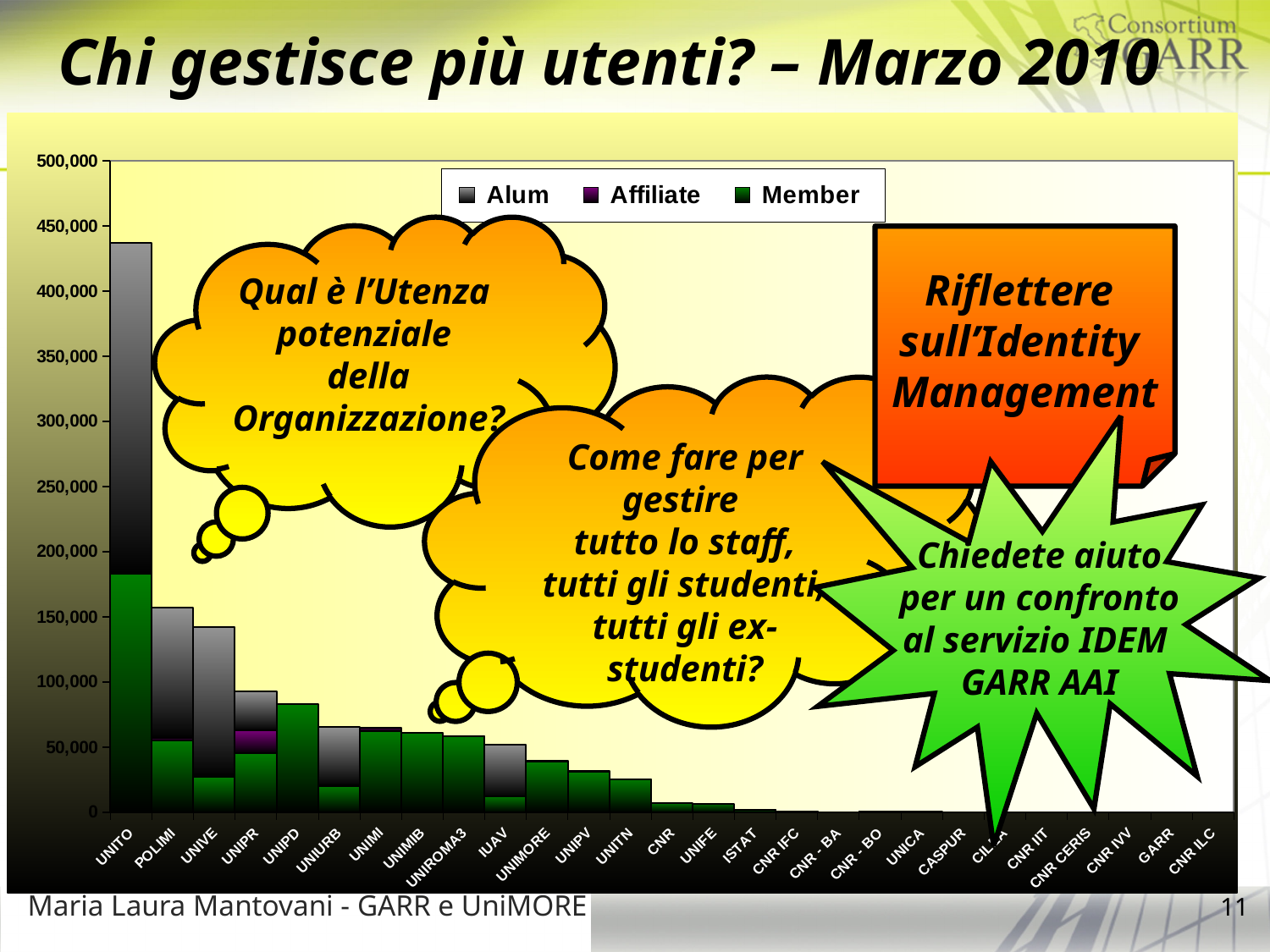
What kind of chart is shown on the slide? stacked bar chart How many series does the legend list? 3 Do the bar totals generally rise or fall from left to right along the x axis? fall Which series is shown in purple? Affiliate Which has the larger total bar, UNITO or POLIMI? UNITO Which series are listed in the legend? Alum, Affiliate, Member Is the Member segment for UNITO greater or less than 150,000? greater Which organisation has the tallest bar? UNITO Is the total bar for UNIPD greater or less than 100,000? less Is the total bar for UNITO greater or less than 400,000? greater Which has the larger total bar, UNIVE or UNIPR? UNIVE